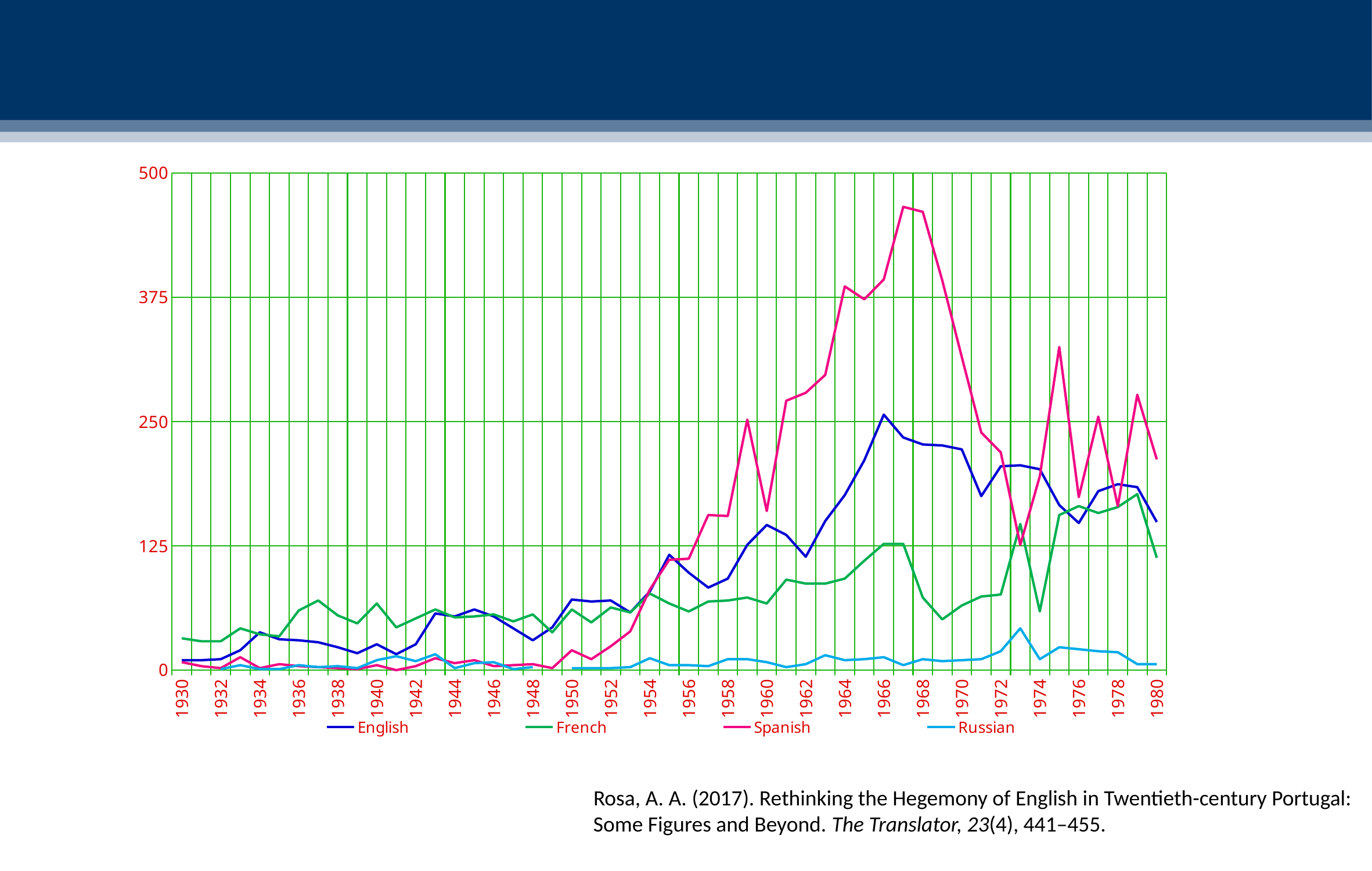
How many series does the legend list? 4 Is the value for French in 1969 greater or less than 125? less Which series has the lowest value in 1967? Russian Which is larger in 1962, the value for English or the value for French? English Which series reaches the highest value anywhere on the chart? Spanish What kind of chart is shown on the slide? Line chart Does the Spanish series rise or fall between 1960 and 1967? Rise Is the value for Spanish in 1975 greater or less than 250? greater Is the value for Spanish in 1967 greater or less than 375? greater Which is larger in 1973, the value for English or the value for Spanish? English Which series does the legend list? English, French, Spanish, Russian How many year labels are shown on the x axis? 26